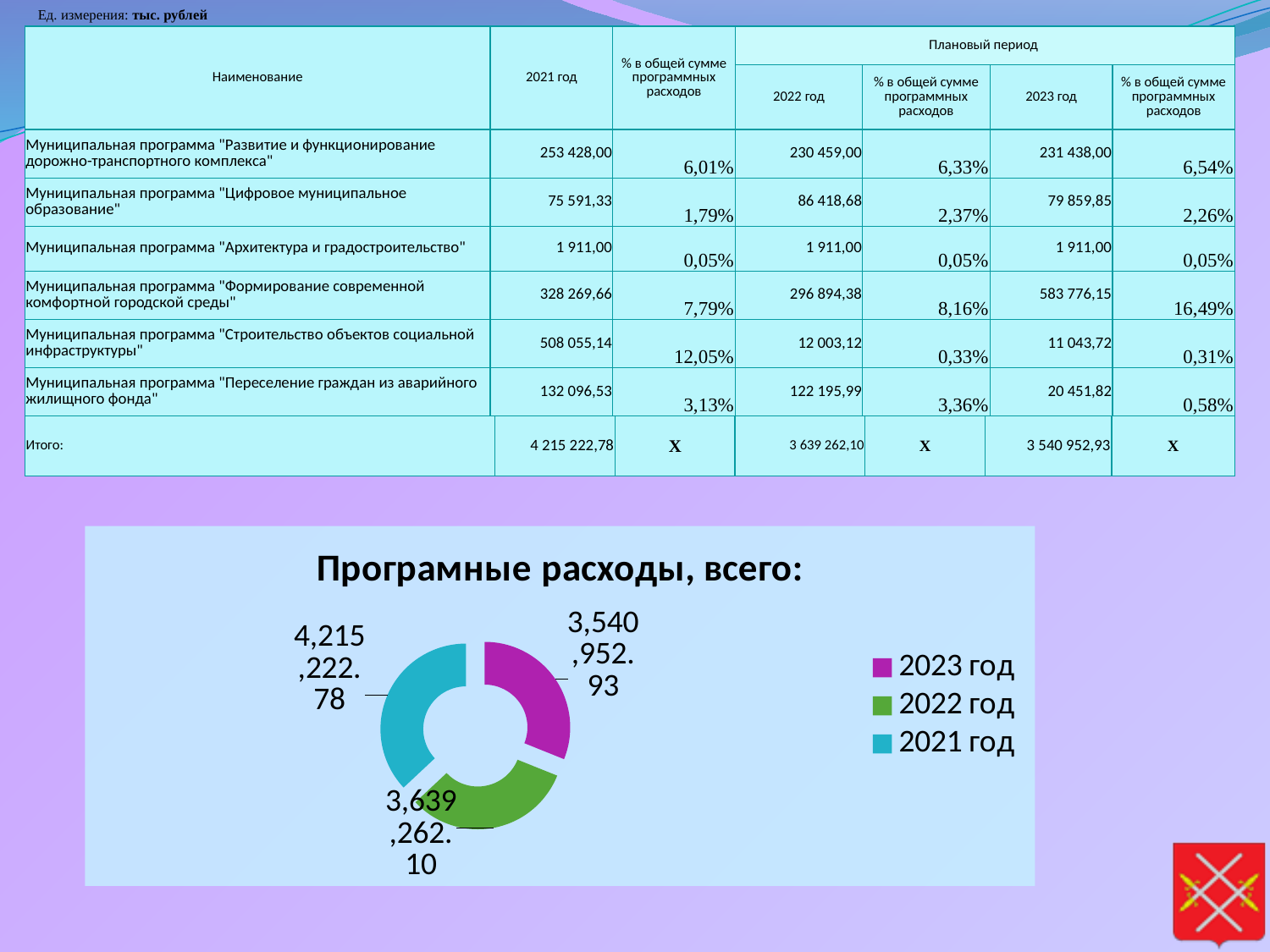
What kind of chart is shown on the slide? Doughnut (pie) chart Which year has the largest value in the chart? 2021 год What is the value shown for 2022 год in the chart? 3,639,262.10 Which colour represents 2023 год in the chart? Magenta (purple) Which year has the smallest value in the chart? 2023 год How many entries does the chart legend list? 3 What is the difference between the values for 2021 год and 2022 год in the chart? 575,960.68 How many slices does the doughnut chart have? 3 What is the title of the chart on the slide? Програмные расходы, всего: Which is larger in the chart, the value for 2022 год or 2023 год? 2022 год What is the value shown for 2023 год in the chart? 3,540,952.93 What is the value shown for 2021 год in the chart? 4,215,222.78